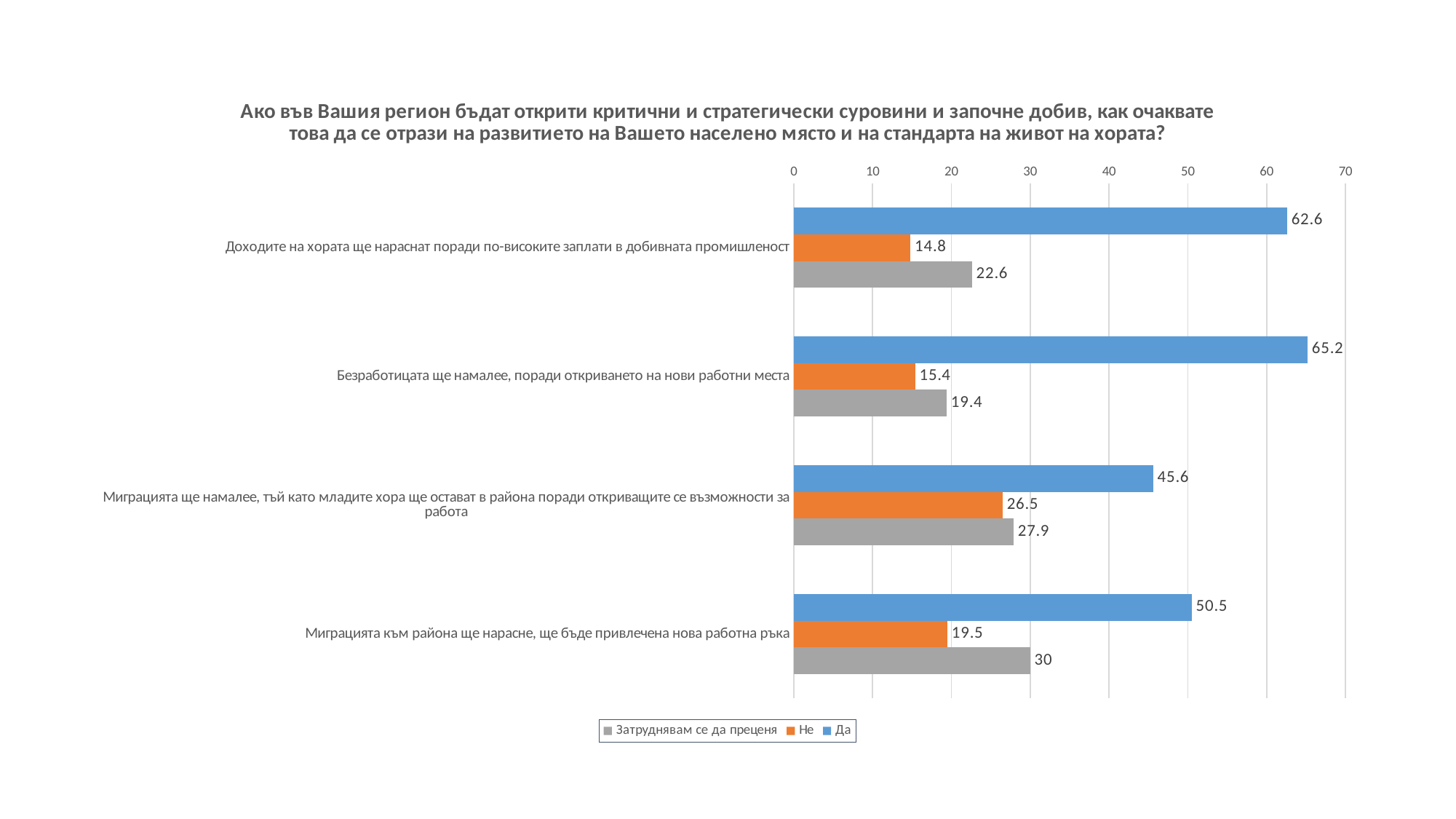
Which colour represents the "Не" series in the chart? Orange What is the value of the "Не" series for "Доходите на хората ще нараснат поради по-високите заплати в добивната промишленост"? 14.8 Which category has the lowest "Да" value? Миграцията ще намалее, тъй като младите хора ще остават в района поради откриващите се възможности за работа How many categories are shown on the chart? 4 Is the "Да" value for "Доходите на хората ще нараснат поради по-високите заплати в добивната промишленост" greater or less than 60? greater How many series does the legend list? 3 What kind of chart is shown on the slide? Bar chart Which category has the highest "Да" value? Безработицата ще намалее, поради откриването на нови работни места For "Миграцията ще намалее, тъй като младите хора ще остават в района поради откриващите се възможности за работа", which is larger: the "Не" value or the "Затруднявам се да преценя" value? Затруднявам се да преценя What is the value of the "Да" series for "Безработицата ще намалее, поради откриването на нови работни места"? 65.2 What is the difference between the "Да" and "Не" values for "Миграцията към района ще нарасне, ще бъде привлечена нова работна ръка"? 31 What is the value of the "Затруднявам се да преценя" series for "Миграцията към района ще нарасне, ще бъде привлечена нова работна ръка"? 30